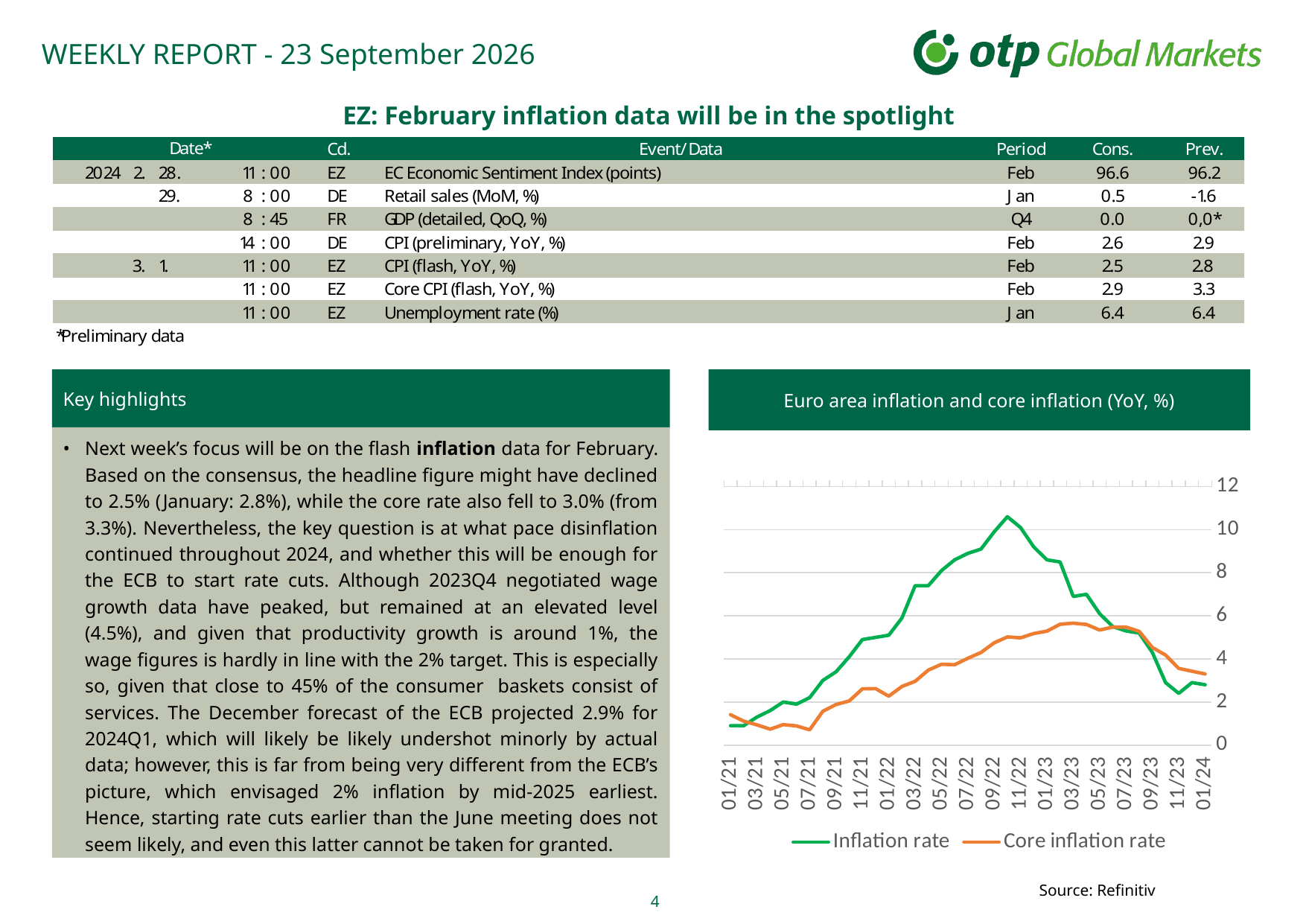
At 09/22, which series has the higher value, Inflation rate or Core inflation rate? Inflation rate Is the value of the Inflation rate at 01/24 greater or less than 4? less How many series does the legend of the chart list? 2 What kind of chart is shown on the slide? line chart Is the peak value of the Core inflation rate series greater or less than 6? less Which series reaches the higher peak value, Inflation rate or Core inflation rate? Inflation rate What is the title of the chart on the slide? Euro area inflation and core inflation (YoY, %) Is the peak value of the Inflation rate series greater or less than 8? greater Which two series are listed in the chart's legend? Inflation rate and Core inflation rate Does the Inflation rate series rise or fall between 11/22 and 01/24? fall At 01/24, which series has the higher value, Inflation rate or Core inflation rate? Core inflation rate